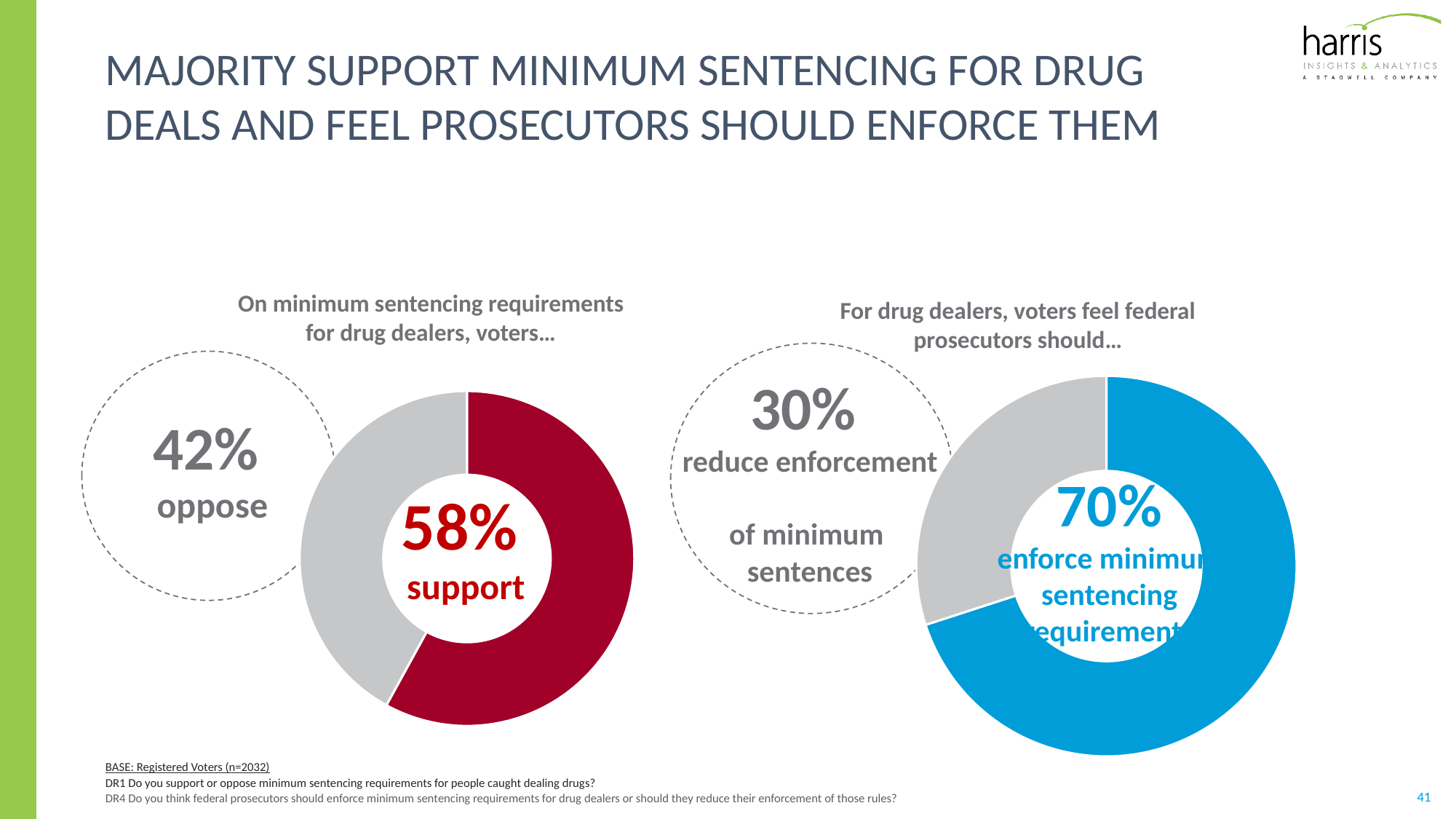
In the right chart, what colour is the segment representing the 70% who feel prosecutors should enforce minimum sentencing requirements? Blue In the left chart, which is larger: the share that support or the share that oppose minimum sentencing requirements? support In the right chart, what is the difference between the percentage for enforcing minimum sentencing requirements and the percentage for reducing enforcement? 40 percentage points In the left chart ('On minimum sentencing requirements for drug dealers, voters...'), what percentage of voters support minimum sentencing requirements? 58% In the left chart, what is the difference between the percentage that support and the percentage that oppose minimum sentencing requirements? 16 percentage points How many segments does the right chart ('For drug dealers, voters feel federal prosecutors should...') have? 2 In the right chart ('For drug dealers, voters feel federal prosecutors should...'), what percentage of voters feel prosecutors should reduce enforcement of minimum sentences? 30% What type of chart is used on the left side of the slide? Doughnut (pie) chart In the left chart ('On minimum sentencing requirements for drug dealers, voters...'), what percentage of voters oppose minimum sentencing requirements? 42% In the right chart, which is larger: the share for enforcing minimum sentencing requirements or the share for reducing enforcement? enforce minimum sentencing requirements In the right chart ('For drug dealers, voters feel federal prosecutors should...'), what percentage of voters feel prosecutors should enforce minimum sentencing requirements? 70% In the left chart, what colour is the segment representing the 58% who support minimum sentencing requirements? Red